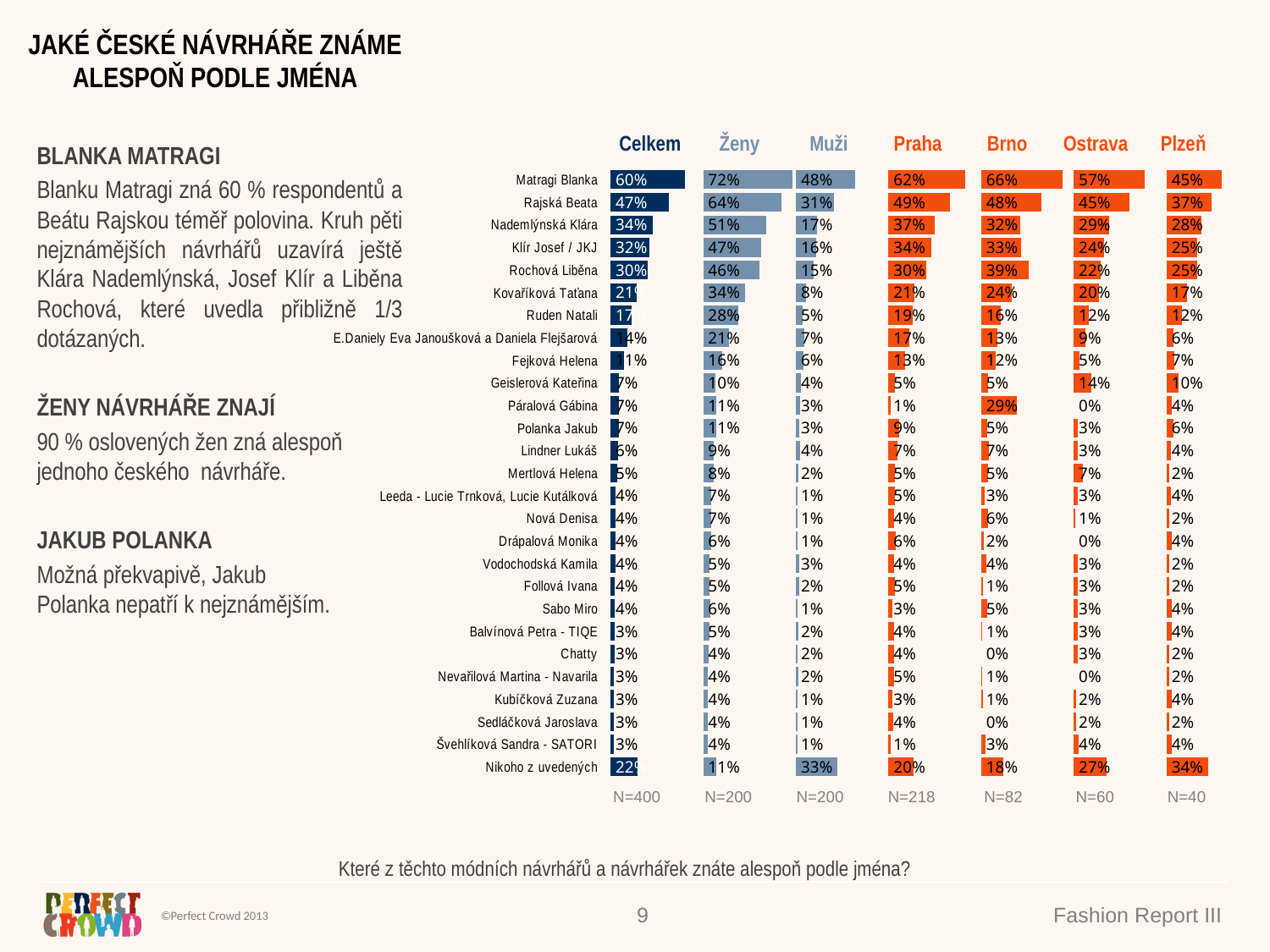
What is the difference between the Praha and Brno values for Rochová Liběna? 9 percentage points In the Plzeň column, what is the value for Nikoho z uvedených? 34% How many respondent groups (columns) are shown in the chart? 7 In the Ženy column, what percentage of women know Matragi Blanka at least by name? 72% In the Celkem column, which designer has the highest value? Matragi Blanka What type of chart is used to display the values on this slide? Bar chart Which is larger for Klír Josef / JKJ: the Praha value or the Ostrava value? Praha What is the difference between the Ženy and Muži values for Nademlýnská Klára? 34 percentage points In the Brno column, what is the value for Páralová Gábina? 29% In the Ostrava column, which designer has the highest value? Matragi Blanka In the Muži column, what is the value for Rajská Beata? 31% Which is larger for Nikoho z uvedených: the Ženy value or the Muži value? Muži